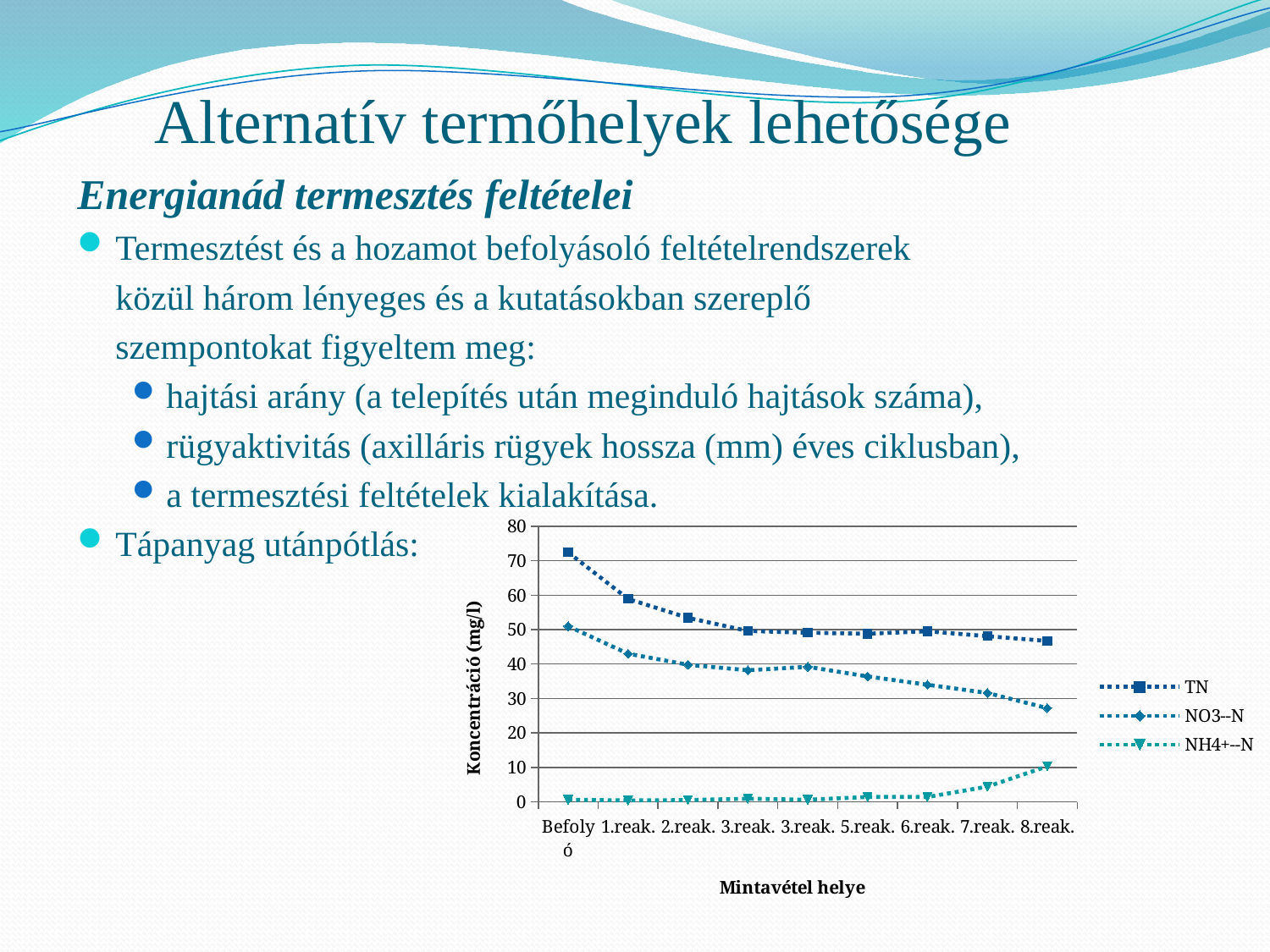
At Befolyó, which series has the larger value, TN or NO3--N? TN What is the title of the chart's vertical axis? Koncentráció (mg/l) Is the NH4+--N value at 8.reak. greater or less than 20? less How many sampling points are plotted along the x axis of the chart? 9 What kind of chart is shown on the slide? line chart At which sampling point is the TN concentration highest? Befolyó Does the NH4+--N concentration rise or fall from 6.reak. to 8.reak.? rise Is the NO3--N value at 8.reak. greater or less than 30? less Does the TN concentration rise or fall from Befolyó to 8.reak.? fall At which sampling point is the NO3--N concentration lowest? 8.reak. How many series does the chart legend list? 3 Is the TN value at Befolyó greater or less than 60? greater